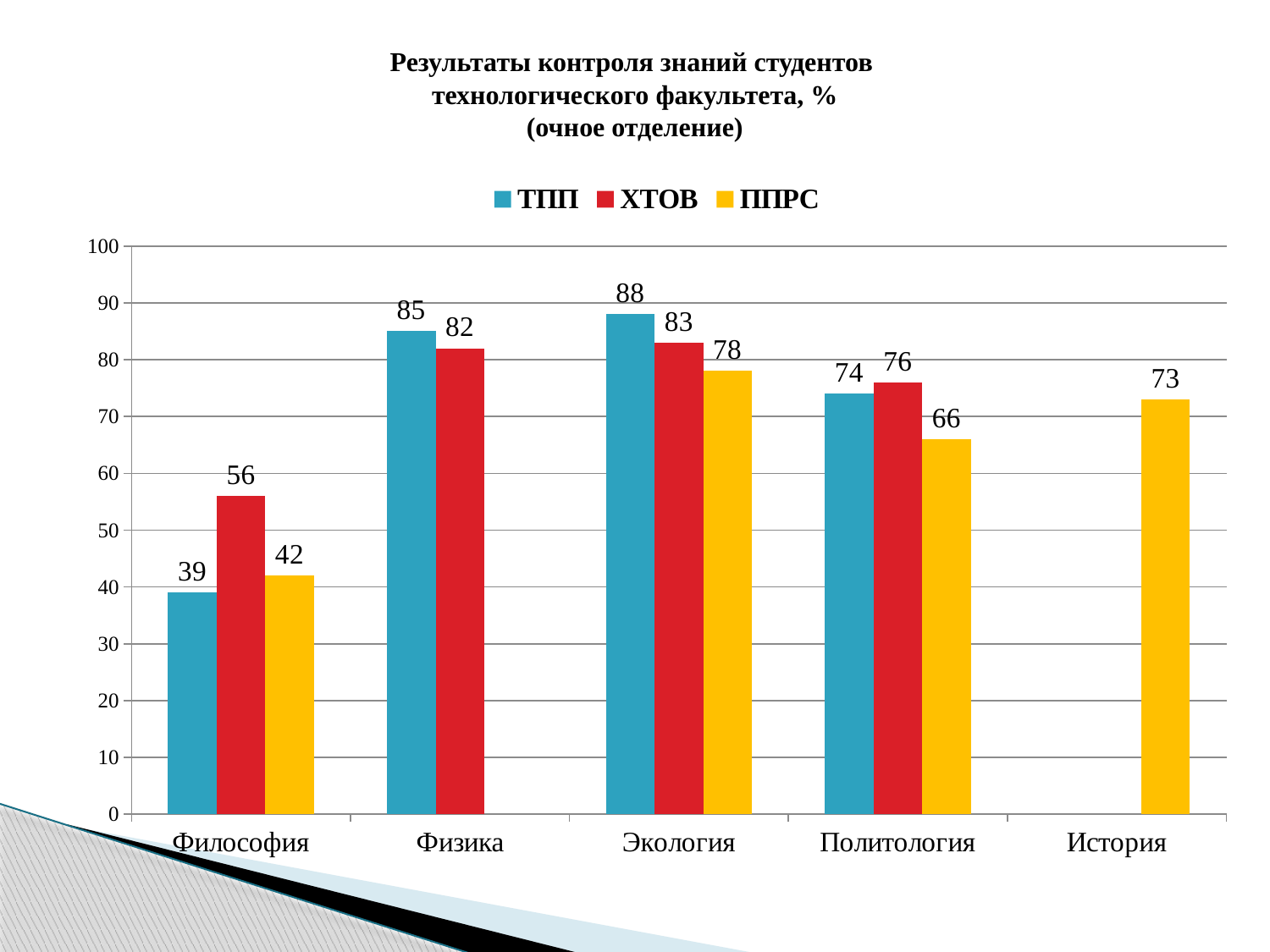
What is the value for ТПП in Экология? 88 How many categories are shown on the x axis? 5 Is the value for ППРС in Политология greater or less than 70? less What is the difference between the ТПП and ППРС values in Политология? 8 What is the value for ХТОВ in Философия? 56 Which category has the lowest value for ППРС? Философия What kind of chart is shown on the slide? bar chart Which is larger in Физика: ТПП or ХТОВ? ТПП Which category has the highest value for ТПП? Экология Which series is shown in red? ХТОВ What is the value for ППРС in История? 73 How many series does the legend list? 3